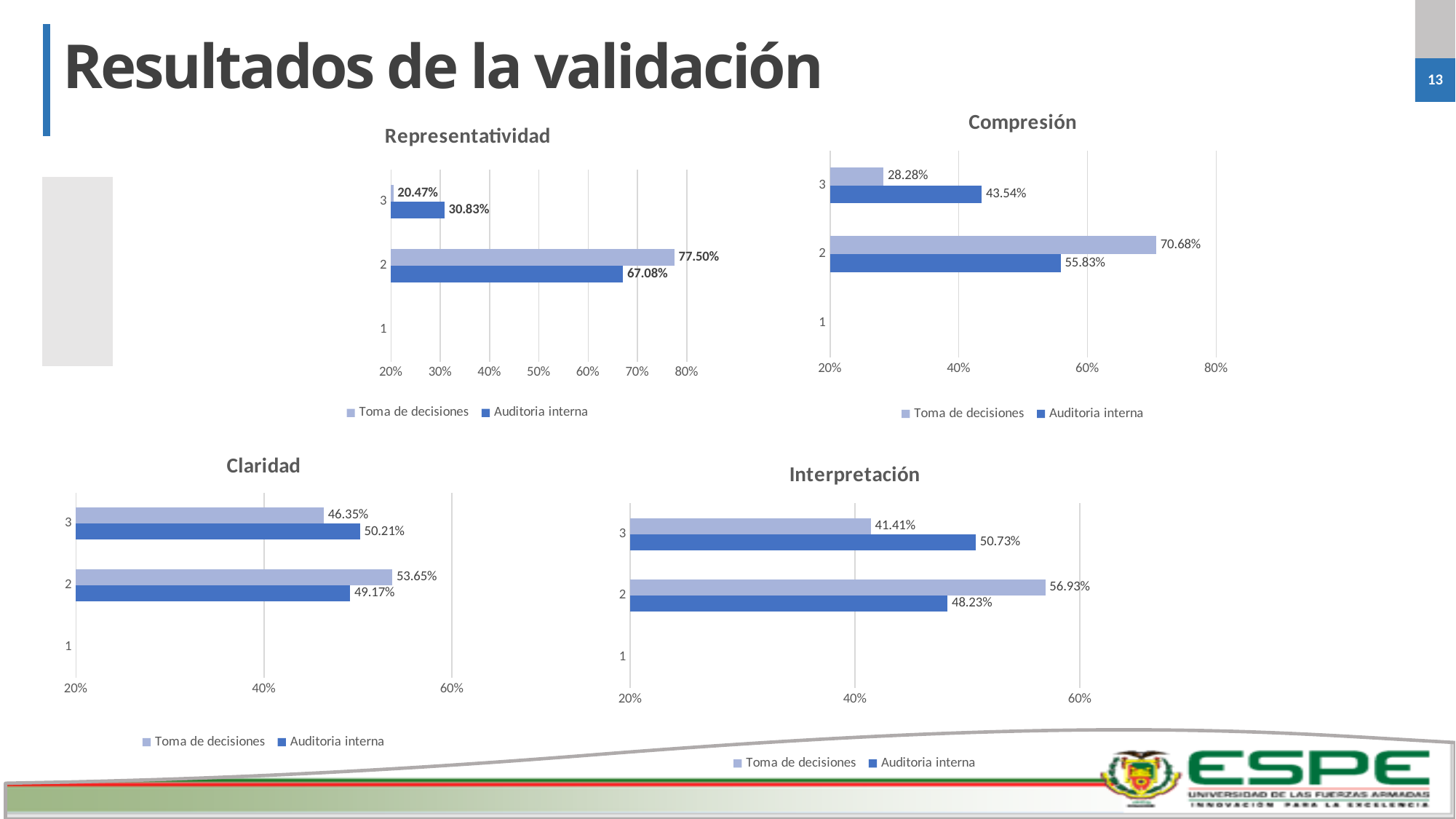
How many series does the legend of the Claridad chart list? 2 In the Representatividad chart, which labelled bar has the highest value? Toma de decisiones for category 2 (77.50%) In the Representatividad chart, what is the value of Auditoria interna for category 3? 30.83% In the Claridad chart, what is the value of Auditoria interna for category 3? 50.21% In the Interpretación chart, what is the value of Toma de decisiones for category 2? 56.93% In the Compresión chart, what is the value of Auditoria interna for category 2? 55.83% In the Compresión chart, what is the difference between Toma de decisiones and Auditoria interna for category 3? 15.26% In the Compresión chart, which labelled bar has the lowest value? Toma de decisiones for category 3 (28.28%) In the Interpretación chart, what is the difference between Auditoria interna and Toma de decisiones for category 3? 9.32% In the Representatividad chart, what is the value of Toma de decisiones for category 2? 77.50% What type of chart is the Interpretación chart? Bar chart In the Claridad chart, which series has the larger value for category 2, Toma de decisiones or Auditoria interna? Toma de decisiones